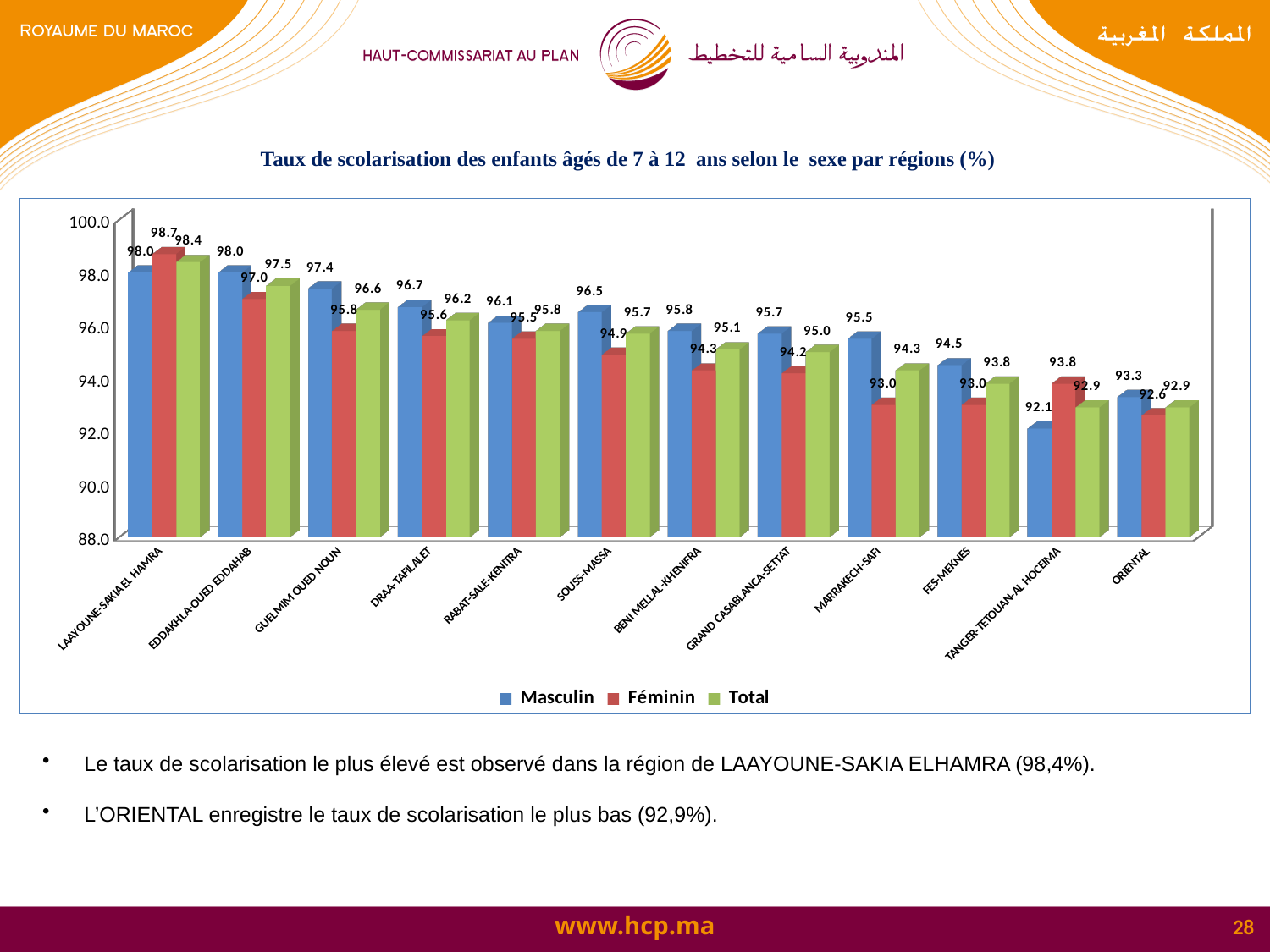
What type of chart is shown on the slide? bar chart Which is larger for TANGER-TETOUAN-AL HOCEIMA, the Masculin value or the Féminin value? Féminin What is the difference between the Masculin and Féminin values for MARRAKECH-SAFI? 2.5 What is the Masculin value for SOUSS-MASSA? 96.5 Which region has the highest Féminin value? LAAYOUNE-SAKIA EL HAMRA What is the title of the chart? Taux de scolarisation des enfants âgés de 7 à 12 ans selon le sexe par régions (%) Do the Total values generally rise or fall from left to right along the x axis? fall What is the Féminin value for TANGER-TETOUAN-AL HOCEIMA? 93.8 What is the Total value for LAAYOUNE-SAKIA EL HAMRA? 98.4 How many regions are shown on the x axis? 12 Which region has the lowest Masculin value? TANGER-TETOUAN-AL HOCEIMA How many series does the legend list? 3